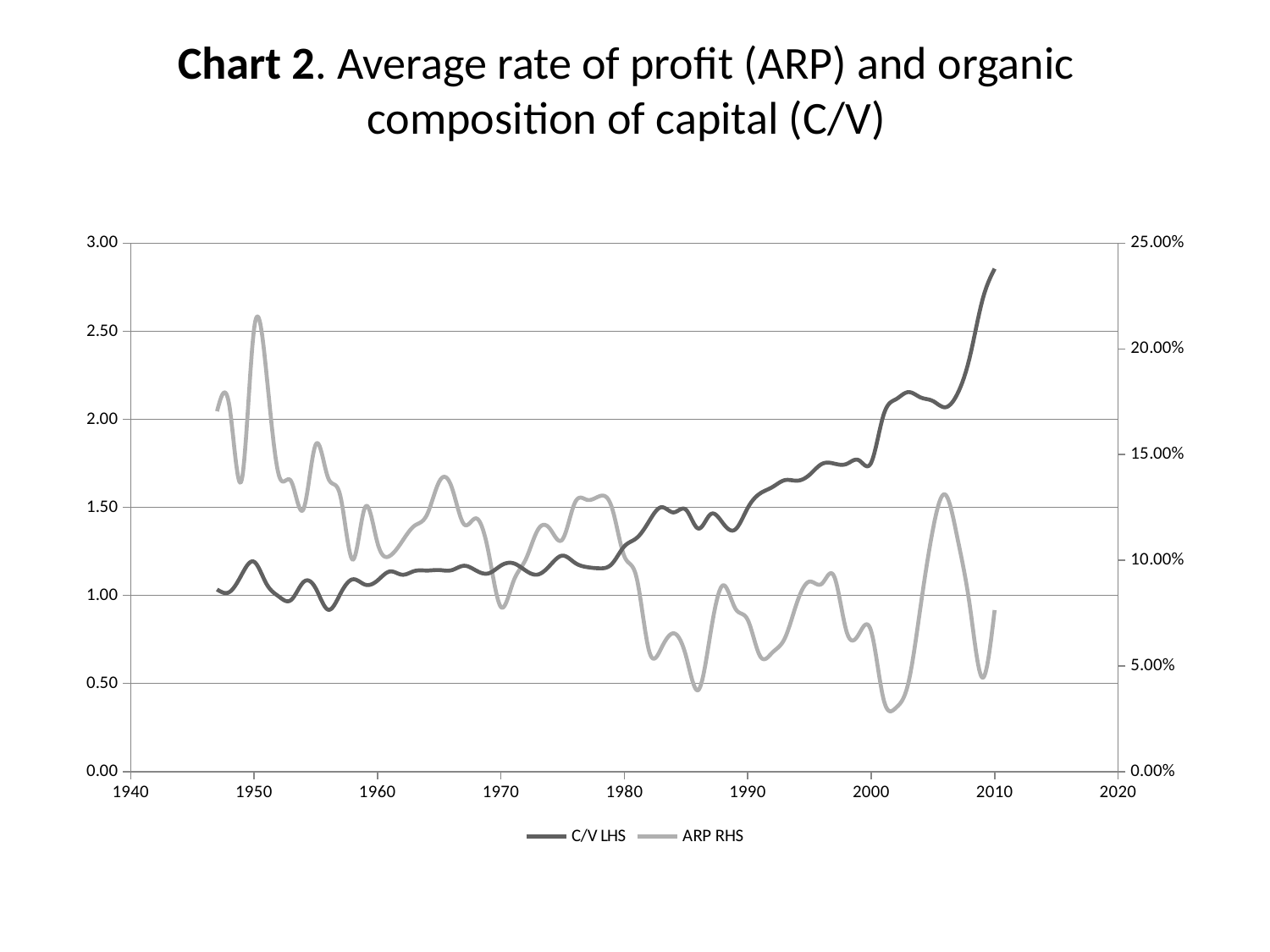
Is the value of ARP RHS at its 1950 peak greater or less than 20.00%? greater Does the ARP RHS series generally rise or fall from 1947 to 2010? fall What are the two series named in the legend? C/V LHS and ARP RHS Is the value of C/V LHS in 2010 greater or less than 2.50? greater Does the C/V LHS series generally rise or fall from 1947 to 2010? rise How many series does the legend list? 2 Is the value of ARP RHS around 2001 greater or less than 5.00%? less In which year does the C/V LHS series reach its highest value? 2010 Which is larger for C/V LHS: the value in 1950 or the value in 2010? 2010 What kind of chart is shown on the slide? line chart What is the title of the chart? Chart 2. Average rate of profit (ARP) and organic composition of capital (C/V)